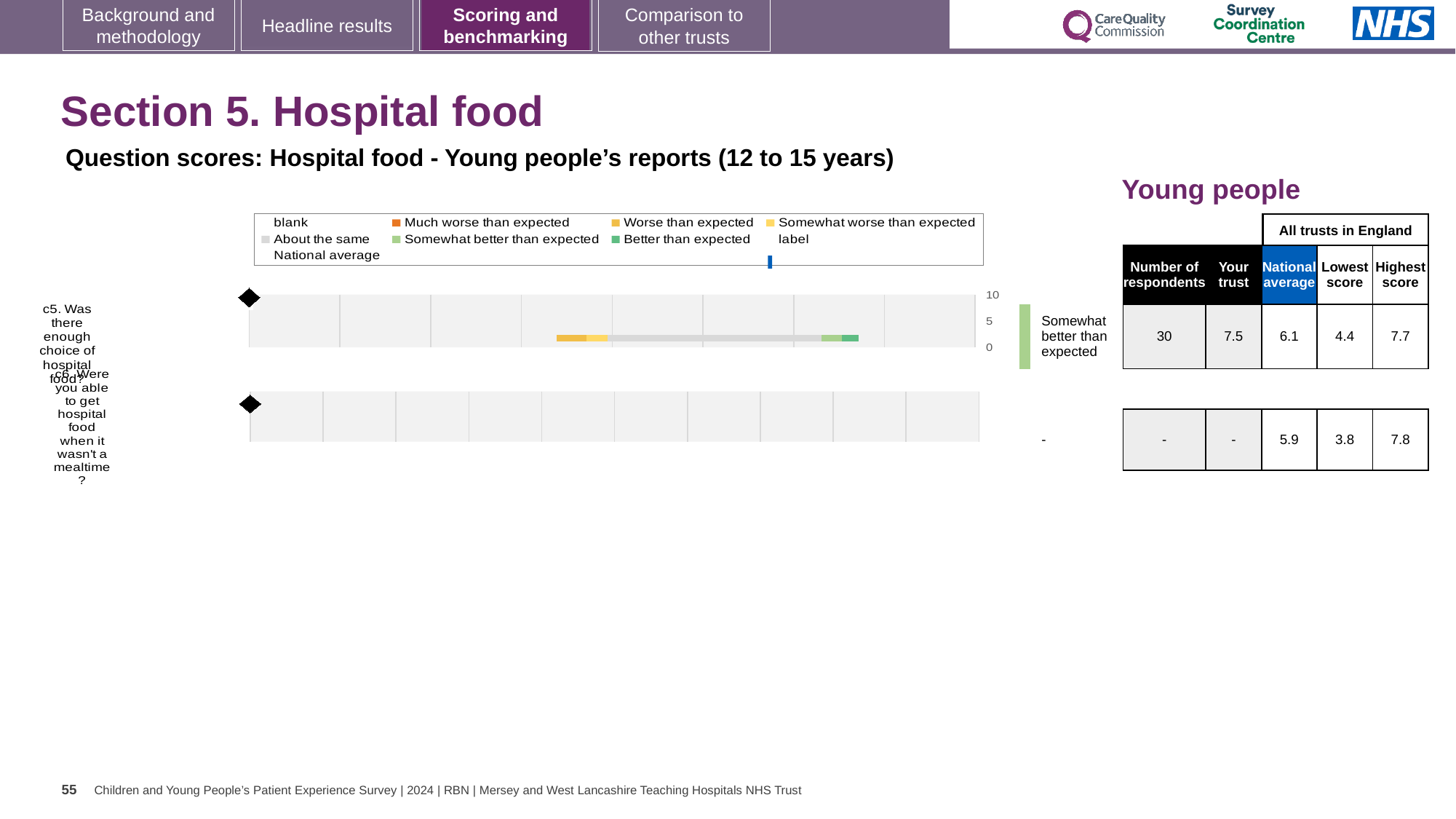
What is the national average score for question c5? 6.1 How many survey questions are plotted on the slide? 2 What is the highest score among all trusts in England for question c6 (Were you able to get hospital food when it wasn't a mealtime?)? 7.8 What is the national average score for question c6? 5.9 What is the lowest score among all trusts in England for question c5? 4.4 For question c5, which is higher: the trust's score or the national average? the trust's score What kind of chart is used to show the question scores for c5 and c6? bar chart What is the trust's score for question c5 (Was there enough choice of hospital food?)? 7.5 What benchmark category is the trust's result for question c5 placed in? Somewhat better than expected Is the trust's score for question c5 greater or less than 5? greater How many respondents answered question c5? 30 What is the difference between the highest and lowest scores for question c5? 3.3